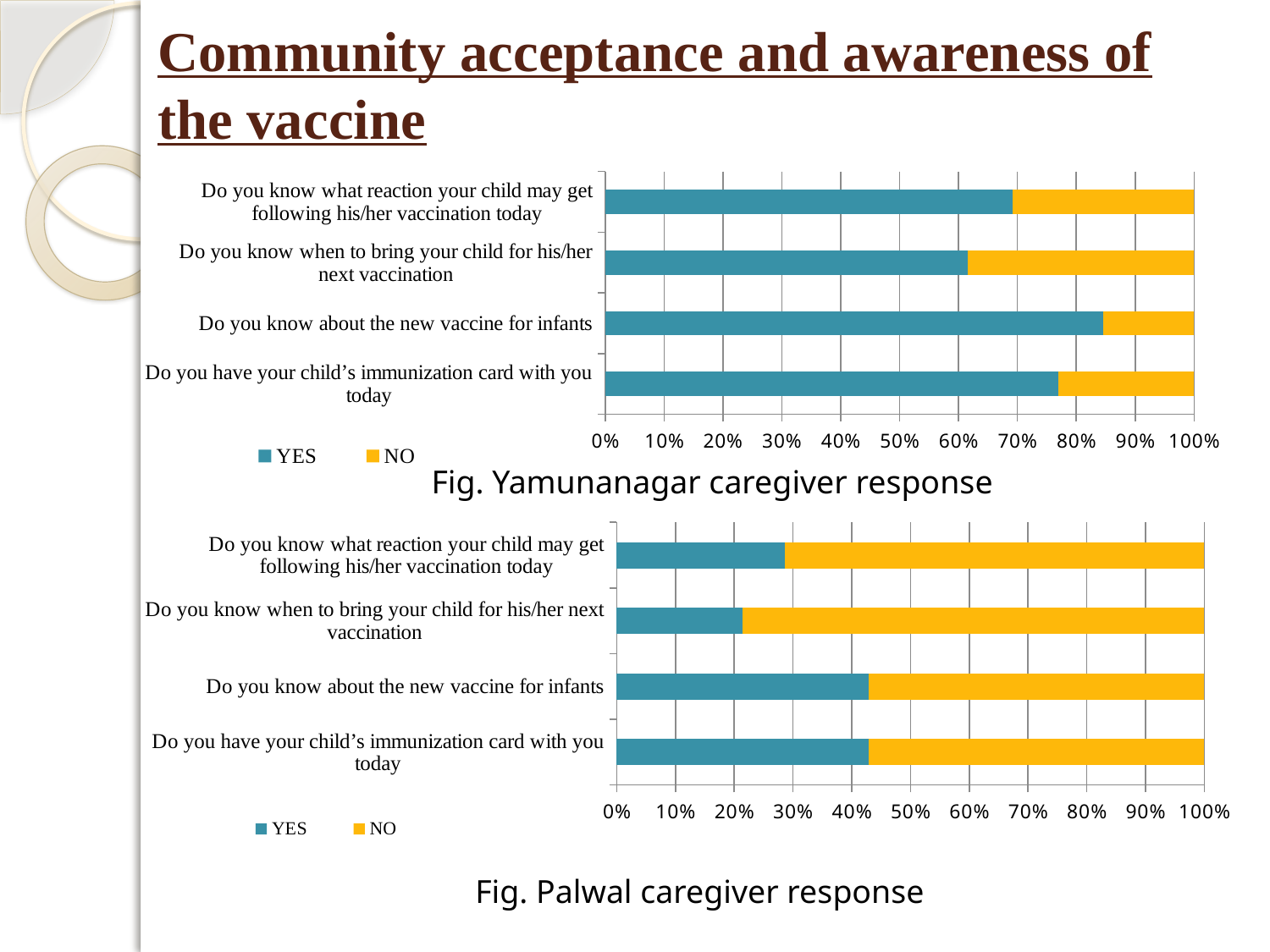
In the Fig. Palwal caregiver response chart, which question has the lowest YES share? Do you know when to bring your child for his/her next vaccination In the Fig. Palwal caregiver response chart, is the YES share for 'Do you know about the new vaccine for infants' greater or less than 50%? less What kind of chart is the Fig. Yamunanagar caregiver response chart? Stacked bar chart For 'Do you know about the new vaccine for infants', is the YES share larger in the Fig. Yamunanagar caregiver response chart or the Fig. Palwal caregiver response chart? Fig. Yamunanagar caregiver response In the Fig. Yamunanagar caregiver response chart, which question has the lowest YES share? Do you know when to bring your child for his/her next vaccination How many questions (categories) are shown in the Fig. Yamunanagar caregiver response chart? 4 In the Fig. Yamunanagar caregiver response chart, is the YES share for 'Do you know about the new vaccine for infants' greater or less than 80%? greater In the Fig. Yamunanagar caregiver response chart, which question has the highest YES share? Do you know about the new vaccine for infants How many series does the legend of the Fig. Palwal caregiver response chart list? 2 In the Fig. Yamunanagar caregiver response chart, is the YES share for 'Do you know what reaction your child may get following his/her vaccination today' greater or less than 60%? greater Which colour represents the NO responses in the Fig. Palwal caregiver response chart? Yellow/orange